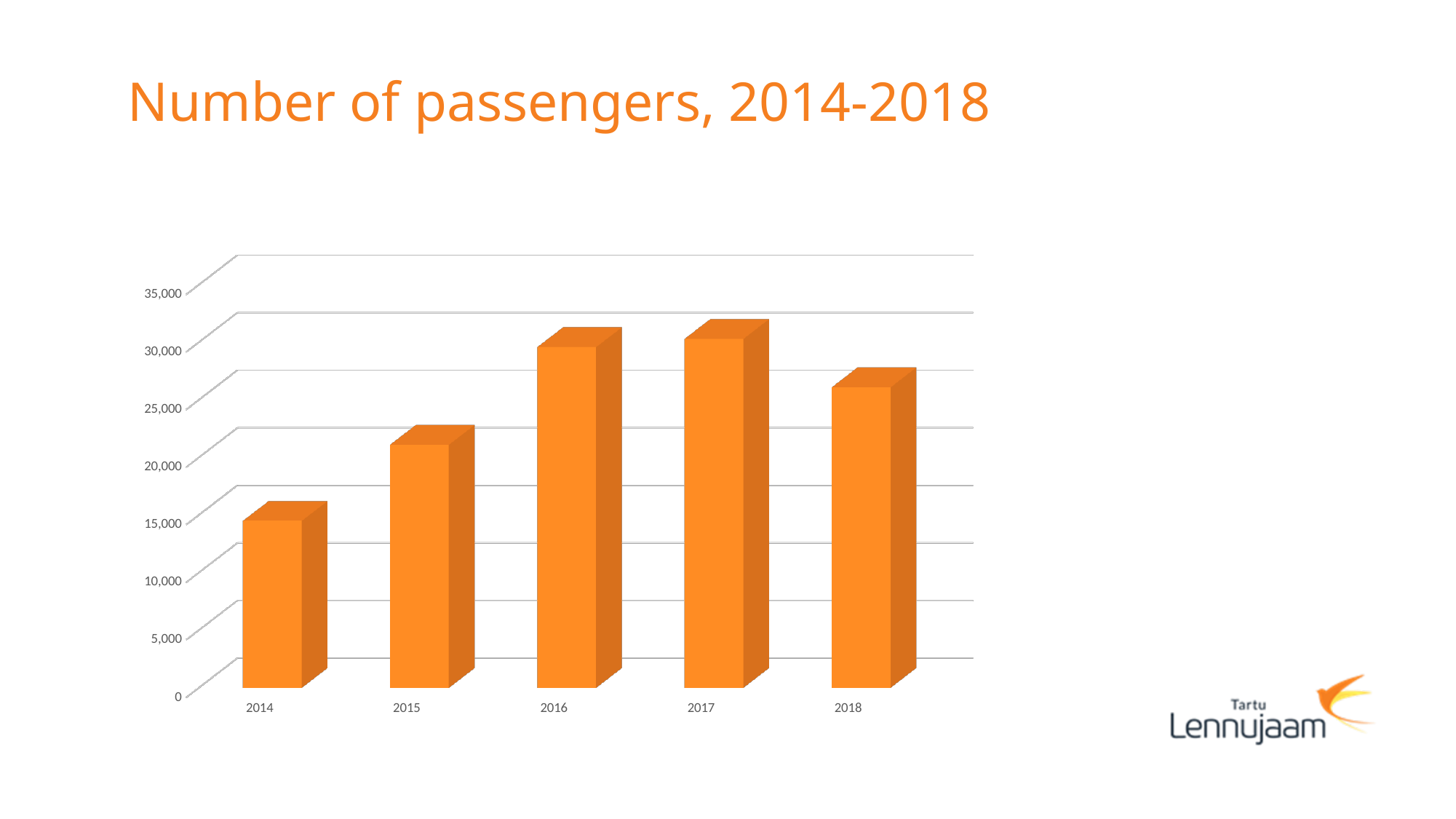
Is the value for 2018 greater or less than 30,000? less Is the value for 2014 greater or less than 20,000? less Is the value for 2016 greater or less than 25,000? greater How does the number of passengers change from 2014 to 2017? It rises What kind of chart is shown on the slide? Bar chart Which year has the lowest number of passengers? 2014 How many years are plotted on the chart? 5 Which year has more passengers, 2014 or 2015? 2015 What is the title of the chart? Number of passengers, 2014-2018 Which year has more passengers, 2016 or 2018? 2016